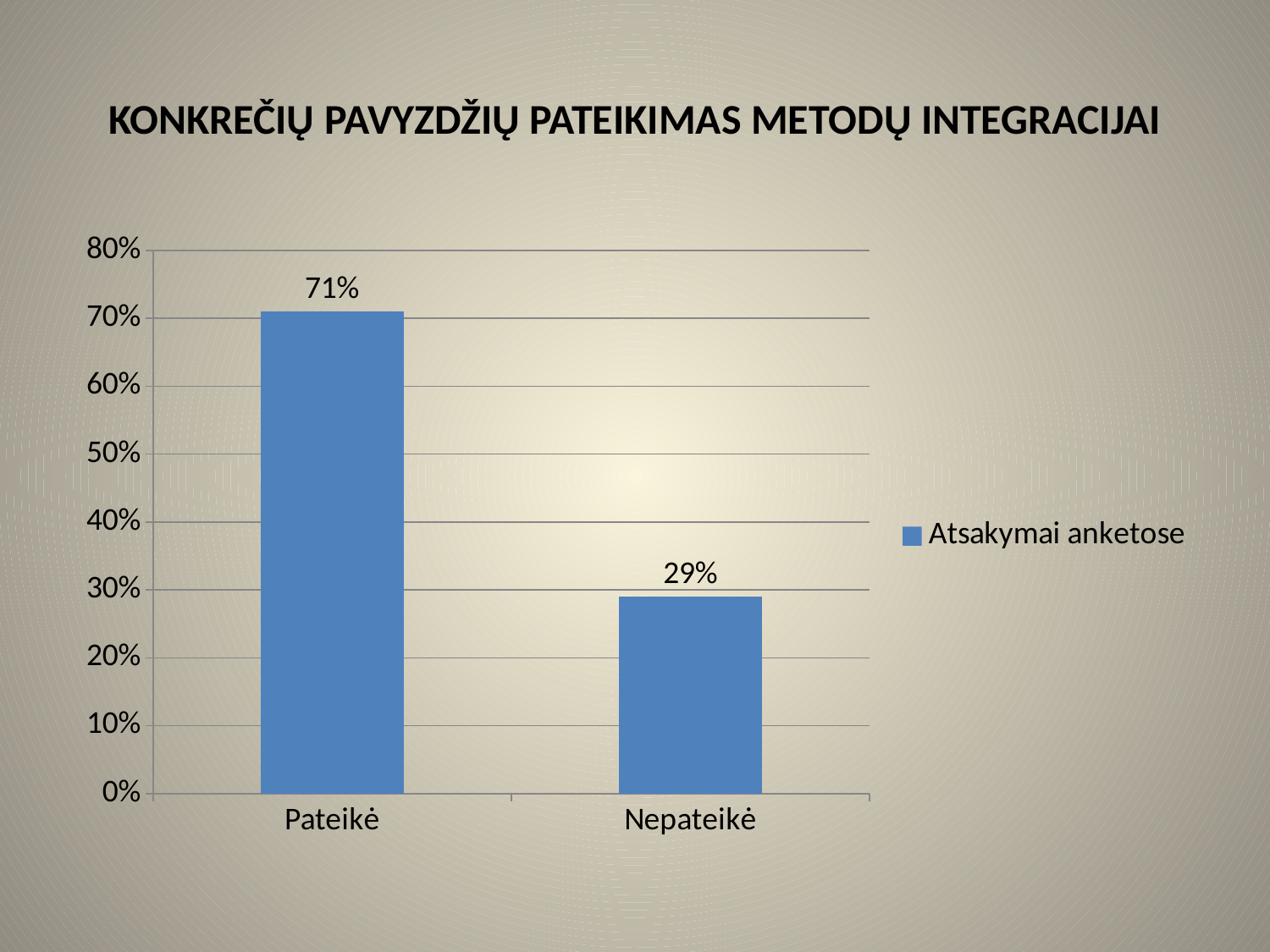
What is the value for Nepateikė? 29% What is the value for Pateikė? 71% What kind of chart is shown on the slide? bar chart Which is larger, the value for Pateikė or the value for Nepateikė? Pateikė How many series does the legend list? 1 Which category has the highest value? Pateikė What is the difference between the values for Pateikė and Nepateikė? 42% What is the name of the series listed in the legend? Atsakymai anketose Which category has the lowest value? Nepateikė Is the value for Pateikė greater or less than 60%? greater How many categories are shown on the x axis? 2 Is the value for Nepateikė greater or less than 40%? less